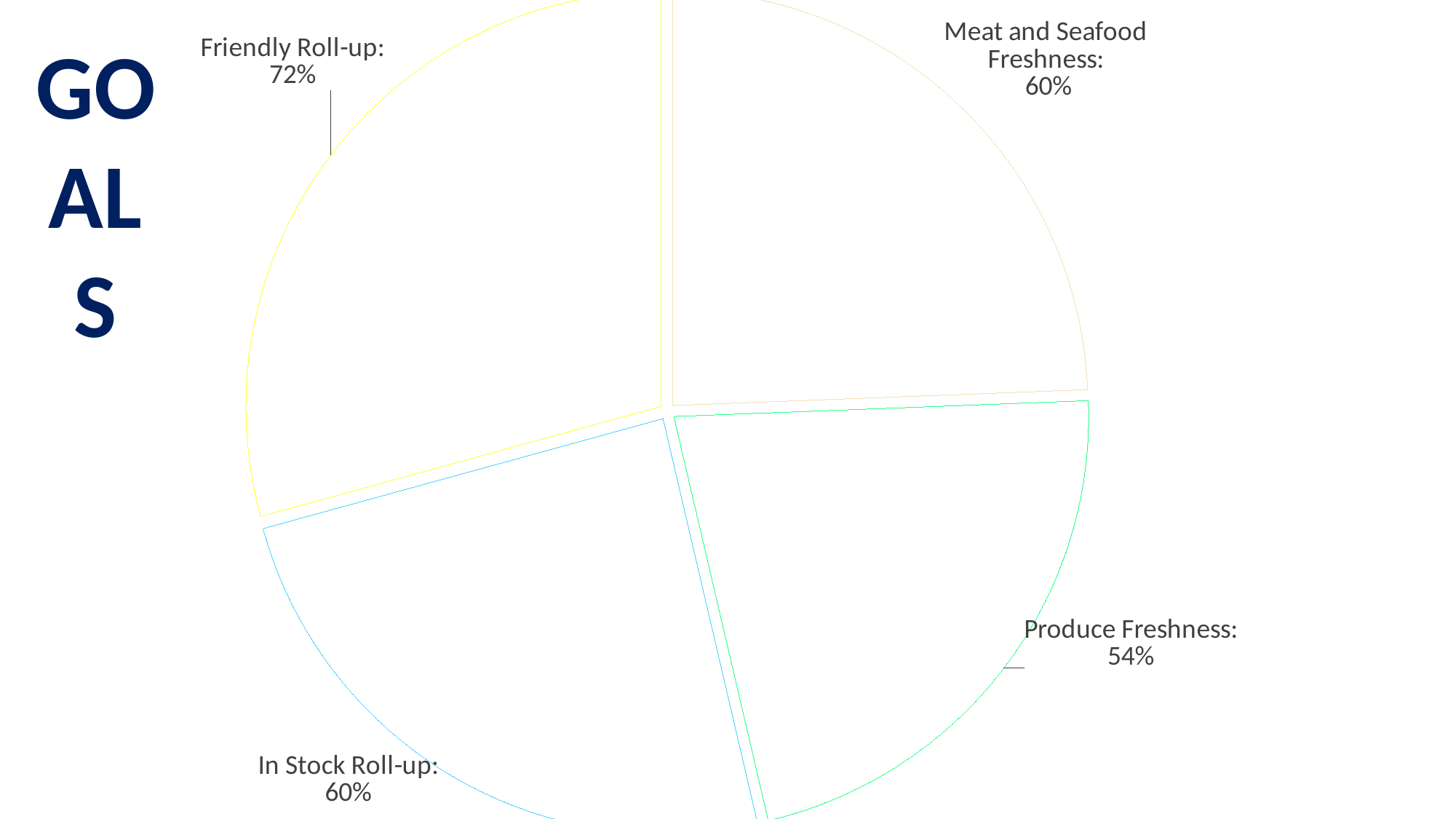
Which is larger, the value for Friendly Roll-up or the value for In Stock Roll-up? Friendly Roll-up What kind of chart is shown on the slide? pie chart What is the value shown for Meat and Seafood Freshness? 60% What is the difference between the values for Friendly Roll-up and Produce Freshness? 18% What is the difference between the values for Meat and Seafood Freshness and Produce Freshness? 6% How many slices does the pie chart have? 4 What is the value shown for Produce Freshness? 54% Which category has the lowest value in the pie chart? Produce Freshness What is the value shown for In Stock Roll-up? 60% Which category has the highest value in the pie chart? Friendly Roll-up What is the title text shown on the left of the slide? GOALS What is the value shown for Friendly Roll-up? 72%